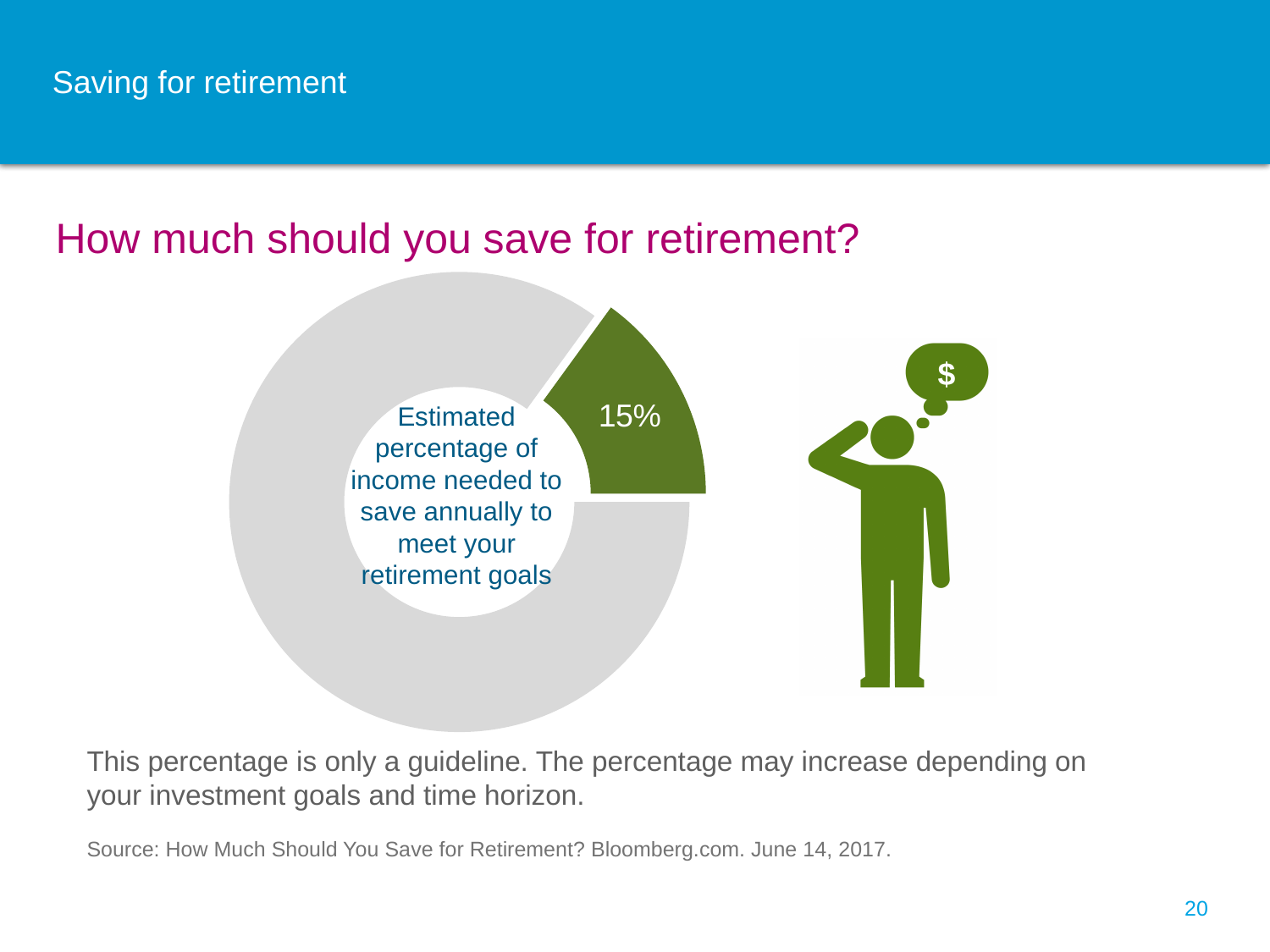
What value is printed on the green slice of the pie chart? 15% What share of the pie chart does the green slice represent? 15% What text appears in the centre of the pie chart? Estimated percentage of income needed to save annually to meet your retirement goals How many slices of the pie chart have a value label printed on them? 1 What kind of chart is shown on the slide? doughnut chart What colour is the slice labelled 15% in the pie chart? green According to the pie chart, what is the estimated percentage of income needed to save annually to meet your retirement goals? 15% Which slice of the pie chart is larger, the green slice or the grey slice? the grey slice Is the green slice of the pie chart greater or less than 50% of the whole? less